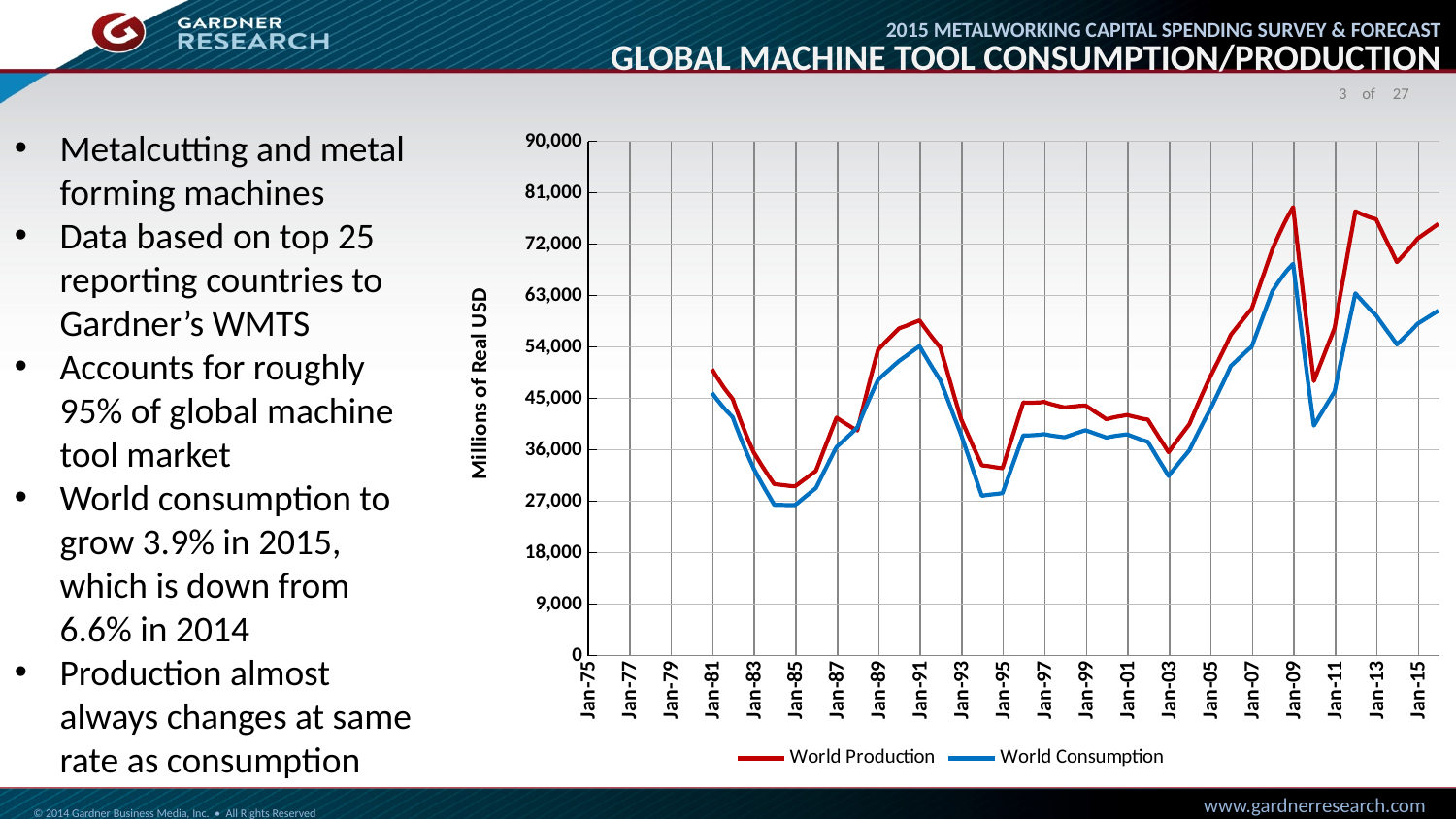
What is the label on the vertical axis of the chart? Millions of Real USD Is the value for World Production at Jan-09 greater or less than 72,000? greater Between Jan-91 and Jan-93, does World Production rise or fall? fall Is the value for World Consumption at Jan-09 greater or less than 63,000? greater Is the value for World Consumption at Jan-85 greater or less than 36,000? less What kind of chart is shown on the slide? line chart What are the two series named in the chart legend? World Production and World Consumption How many series does the chart legend list? 2 At Jan-11, which series has the larger value, World Production or World Consumption? World Production Between Jan-03 and Jan-09, does World Consumption rise or fall? rise